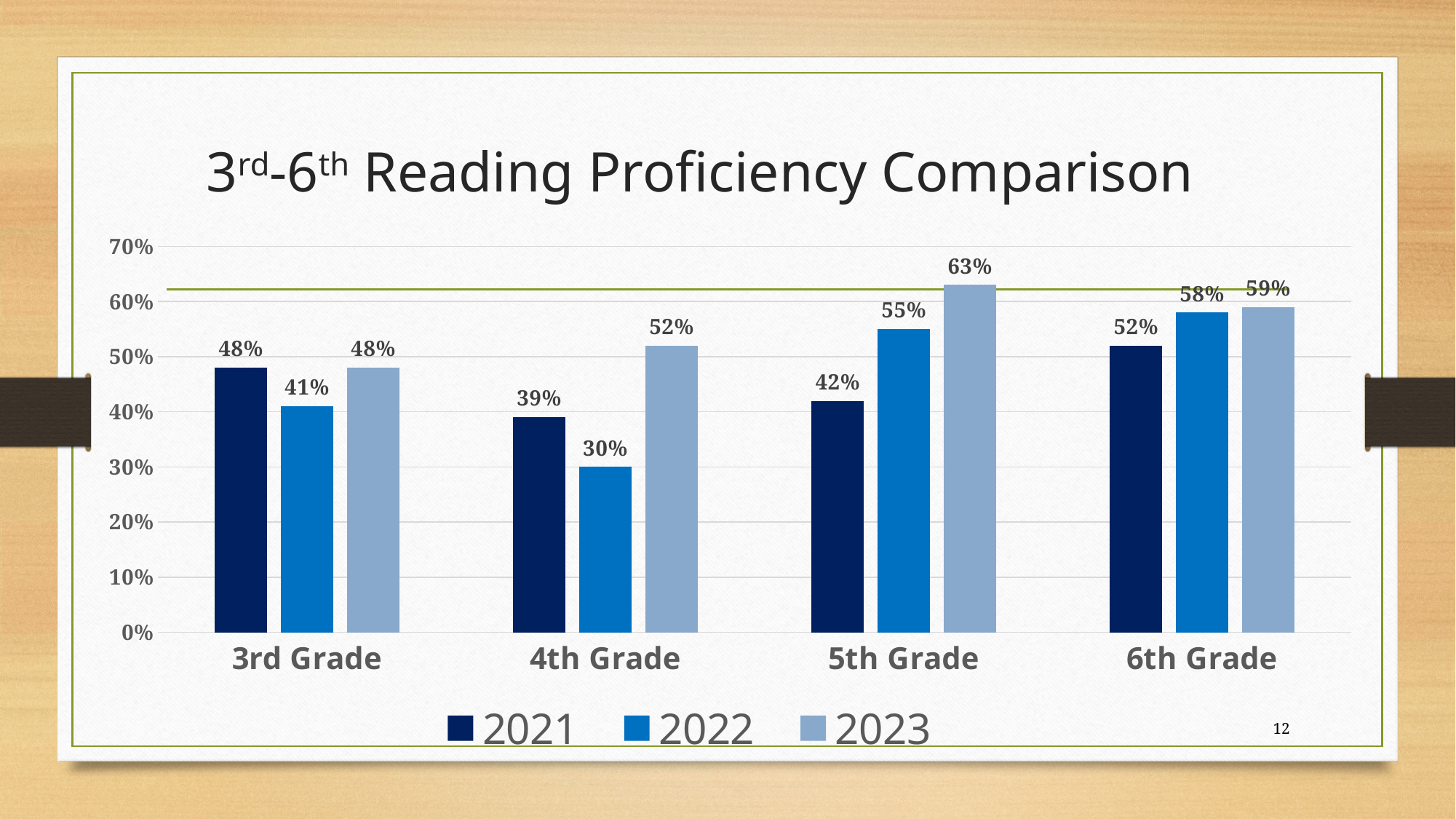
What kind of chart is shown on the slide? bar chart Is the 2023 value for 5th Grade greater or less than 60%? greater Which grade has the highest 2023 value? 5th Grade How many grade categories are shown on the x axis? 4 Which grade has the lowest 2022 value? 4th Grade What is the difference between the 2023 and 2022 values for 4th Grade? 22% What is the 2021 value for 6th Grade? 52% What is the 2022 value for 4th Grade? 30% What is the title of the chart on the slide? 3rd-6th Reading Proficiency Comparison How many series does the legend list? 3 What is the 2023 reading proficiency value for 5th Grade? 63% Which is larger for 3rd Grade, the 2021 value or the 2022 value? 2021